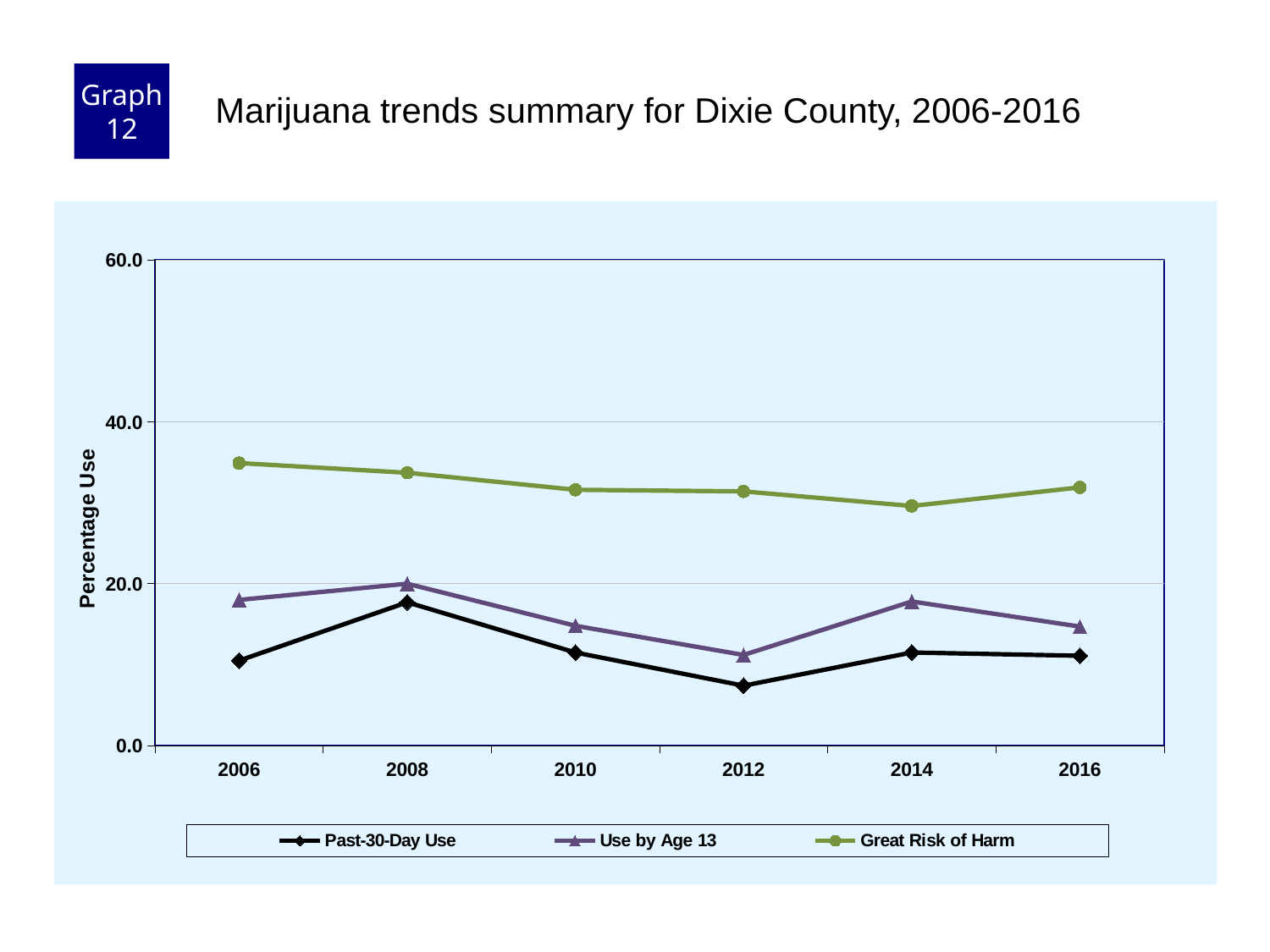
Is the value for Great Risk of Harm in 2006 greater or less than 40.0? less Is the value for Past-30-Day Use in 2012 greater or less than 20.0? less Which series has the highest values across all years? Great Risk of Harm How many years are plotted along the x axis? 6 What kind of chart is shown on the slide? line chart In which year is the Great Risk of Harm value lowest? 2014 How many series does the legend list? 3 Does the Great Risk of Harm line rise or fall from 2006 to 2014? fall In which year is the Past-30-Day Use value highest? 2008 Which is larger in 2010, Great Risk of Harm or Past-30-Day Use? Great Risk of Harm What is the label on the y axis? Percentage Use In which year is the Past-30-Day Use value lowest? 2012